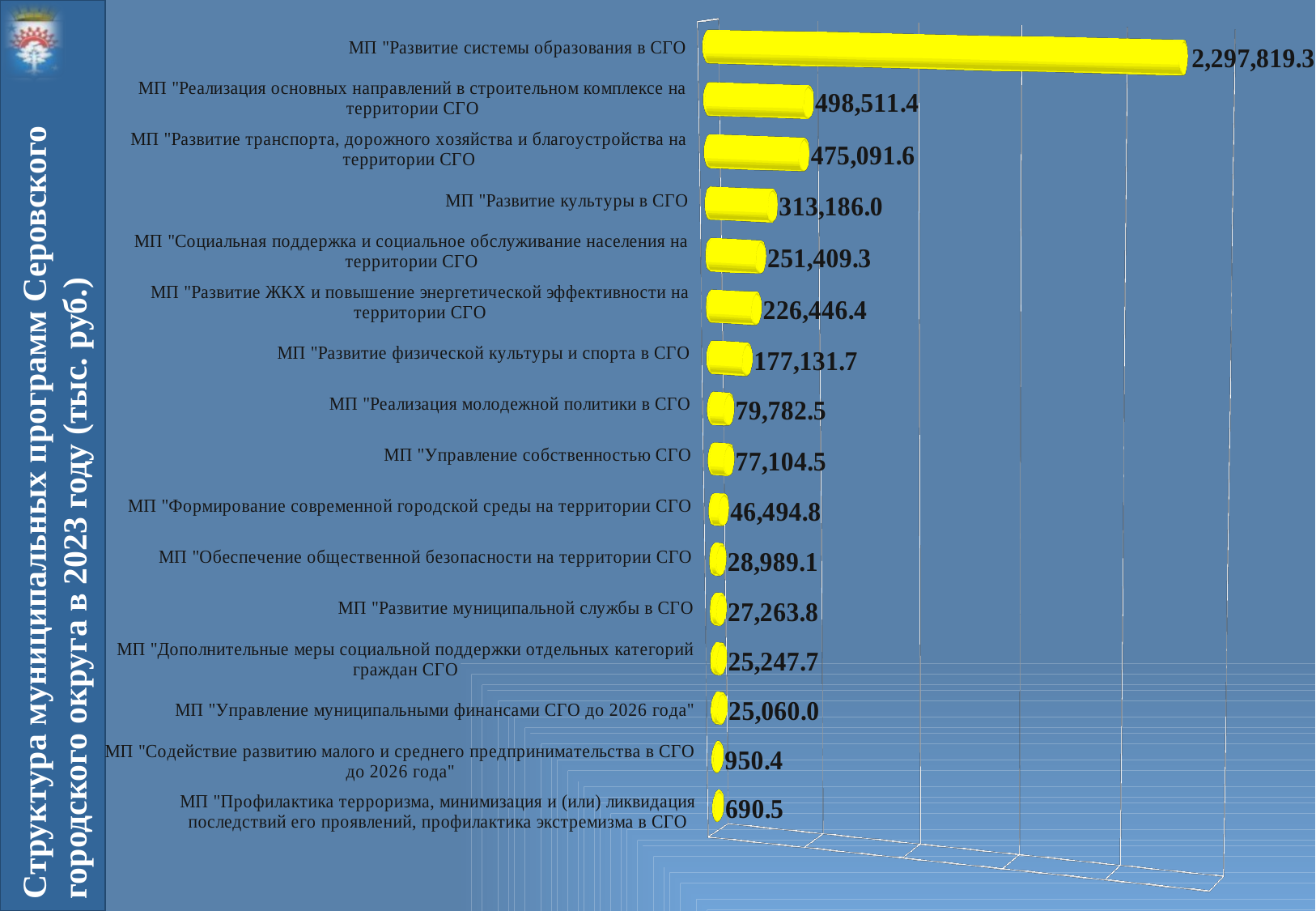
What is the difference between the values for МП "Содействие развитию малого и среднего предпринимательства в СГО до 2026 года" and МП "Профилактика терроризма, минимизация и (или) ликвидация последствий его проявлений, профилактика экстремизма в СГО"? 259.9 How many programs (bars) are shown in the chart? 16 What is the value for МП "Реализация молодежной политики в СГО"? 79,782.5 Which program has the lowest value? МП "Профилактика терроризма, минимизация и (или) ликвидация последствий его проявлений, профилактика экстремизма в СГО" What is the title of the slide? Структура муниципальных программ Серовского городского округа в 2023 году (тыс. руб.) Which is larger: the value for МП "Развитие культуры в СГО" or МП "Социальная поддержка и социальное обслуживание населения на территории СГО"? МП "Развитие культуры в СГО" What is the difference between the values for МП "Реализация основных направлений в строительном комплексе на территории СГО" and МП "Развитие транспорта, дорожного хозяйства и благоустройства на территории СГО"? 23,419.8 What is the value for МП "Развитие системы образования в СГО"? 2,297,819.3 Which program has the highest value? МП "Развитие системы образования в СГО" What kind of chart is shown on the slide? Bar chart What is the value for МП "Развитие культуры в СГО"? 313,186.0 What is the value for МП "Управление муниципальными финансами СГО до 2026 года"? 25,060.0